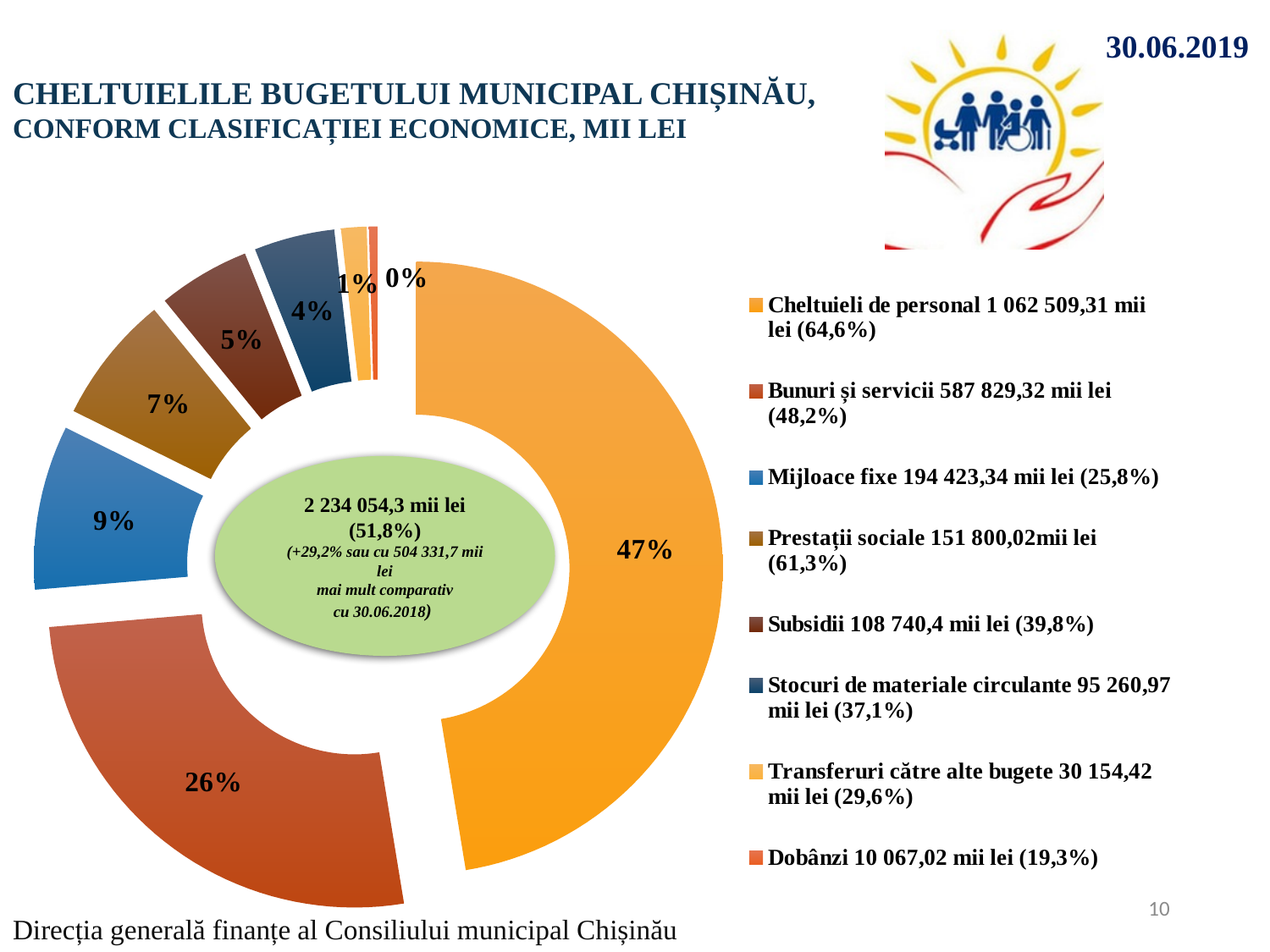
What total amount is shown in the centre of the doughnut chart? 2 234 054,3 mii lei Which slice is larger, Prestații sociale or Stocuri de materiale circulante? Prestații sociale What kind of chart is shown on the slide? Doughnut chart How many categories does the legend list? 8 What share of the doughnut chart does Cheltuieli de personal represent? 47% What share of the doughnut chart does Bunuri și servicii represent? 26% What share of the doughnut chart does Mijloace fixe represent? 9% What is the difference in percentage points between the Cheltuieli de personal slice and the Bunuri și servicii slice? 21 percentage points What amount in mii lei is shown in the legend for Mijloace fixe? 194 423,34 mii lei Which category has the smallest slice in the doughnut chart? Dobânzi Which category has the largest slice in the doughnut chart? Cheltuieli de personal